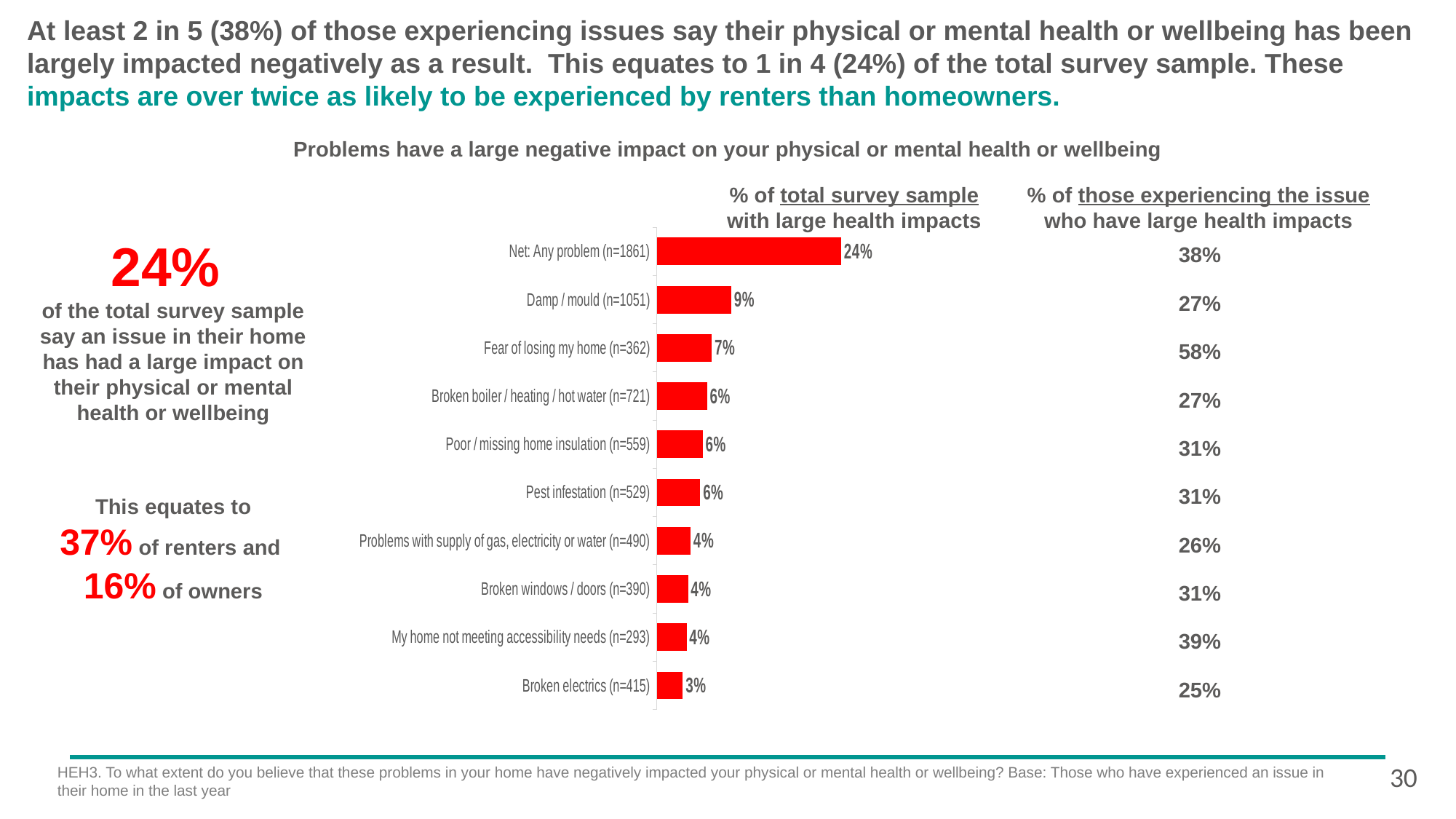
How many categories (bars) are shown in the chart, including the Net: Any problem bar? 10 What percentage of those experiencing broken electrics have large health impacts? 25% What percentage of those experiencing fear of losing my home have large health impacts? 58% Which is larger in the % of total survey sample column: damp / mould or pest infestation? Damp / mould Which issue has the lowest percentage of the total survey sample with large health impacts? Broken electrics Excluding the Net: Any problem bar, which issue has the highest percentage of the total survey sample with large health impacts? Damp / mould What is the title of the chart? Problems have a large negative impact on your physical or mental health or wellbeing What percentage of the total survey sample report large health impacts from damp / mould? 9% What percentage of the total survey sample report large health impacts from fear of losing my home? 7% What is the difference between the Net: Any problem bar (24%) and the damp / mould bar (9%) in the % of total survey sample column? 15% Among the individual issues, which has the highest percentage of those experiencing the issue who have large health impacts? Fear of losing my home What type of chart is used to show the % of total survey sample with large health impacts? Bar chart